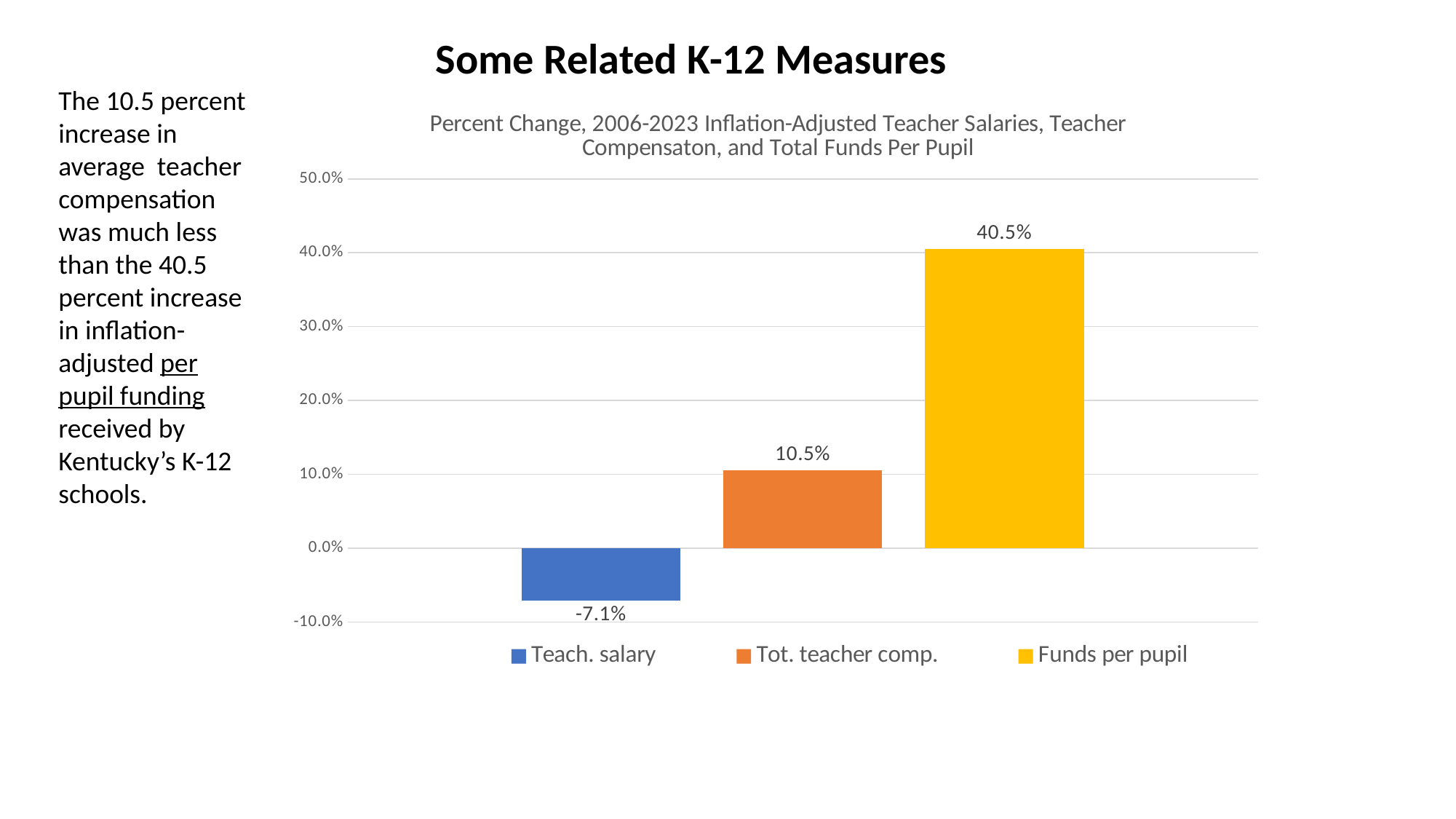
Is the value for Funds per pupil greater or less than 30.0%? greater Which measure has the highest percent change? Funds per pupil What colour is the bar for Funds per pupil? yellow What kind of chart is shown on the slide? bar chart What is the difference between the percent change for Funds per pupil and Tot. teacher comp.? 30.0% What is the difference between the percent change for Tot. teacher comp. and Teach. salary? 17.6% What is the percent change for Funds per pupil? 40.5% What is the percent change for Teach. salary? -7.1% What is the percent change for Tot. teacher comp.? 10.5% Which measure has the lowest percent change? Teach. salary Which is larger, the percent change for Tot. teacher comp. or Teach. salary? Tot. teacher comp. How many bars are plotted in the chart? 3